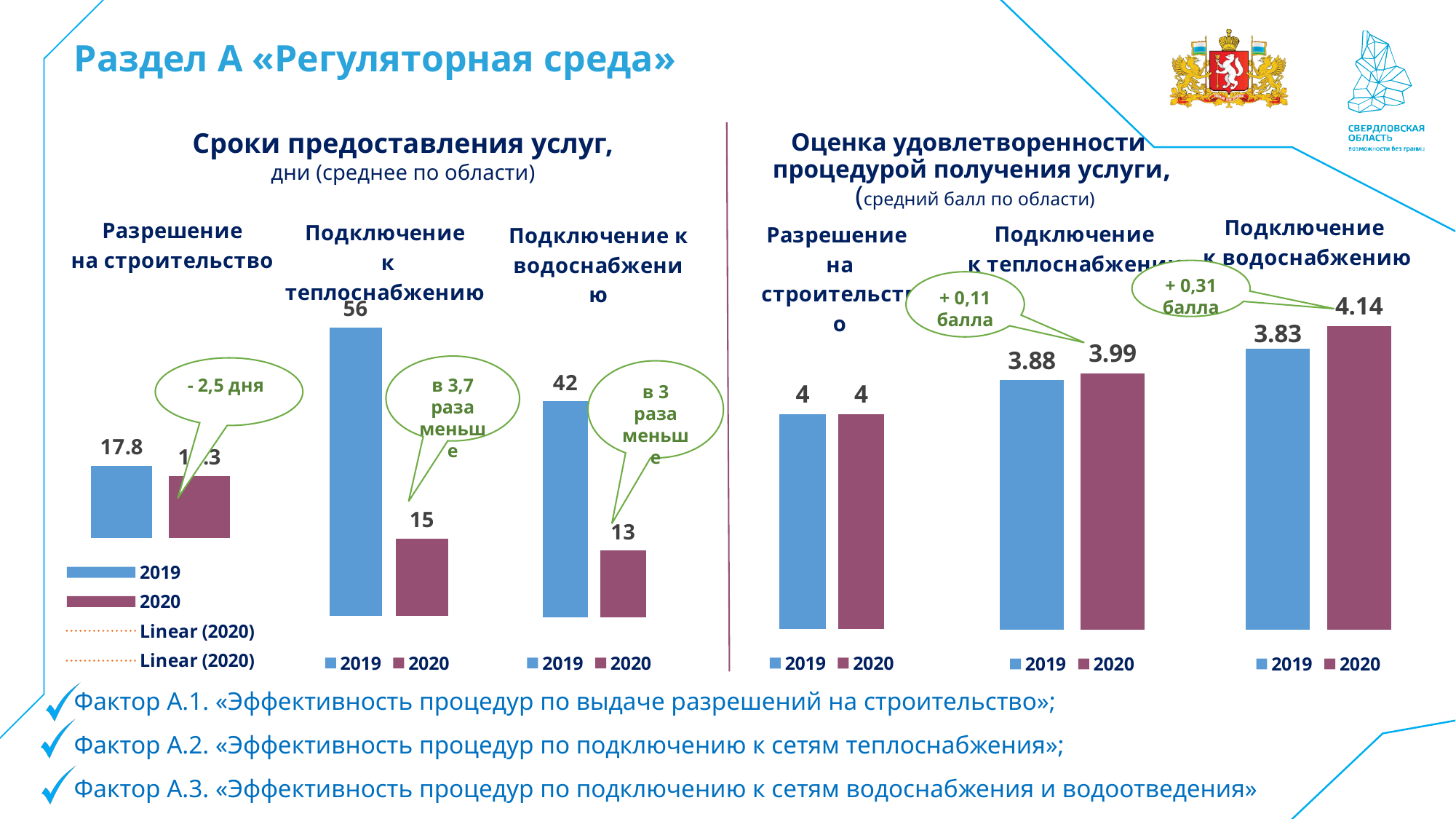
In the 'Оценка удовлетворенности' chart for 'Подключение к водоснабжению', what is the value for 2020? 4.14 How many series does the legend list in the 'Оценка удовлетворенности' chart for 'Подключение к теплоснабжению'? 2 In the 'Сроки предоставления услуг' chart for 'Подключение к водоснабжению', what is the difference between the 2019 and 2020 values? 29 In the 'Сроки предоставления услуг' chart for 'Подключение к водоснабжению', what is the value for 2020? 13 In the 'Оценка удовлетворенности' chart for 'Разрешение на строительство', what is the value for 2020? 4 In the 'Сроки предоставления услуг' chart for 'Подключение к теплоснабжению', what is the value for 2020? 15 In the 'Сроки предоставления услуг' chart for 'Подключение к теплоснабжению', what is the value for 2019? 56 In the 'Сроки предоставления услуг' chart for 'Разрешение на строительство', what is the value for 2019? 17.8 What type of chart is used for 'Сроки предоставления услуг' on the slide? Bar chart In the 'Сроки предоставления услуг' chart for 'Подключение к теплоснабжению', which year has the larger value, 2019 or 2020? 2019 In the 'Оценка удовлетворенности' chart for 'Подключение к теплоснабжению', what is the value for 2019? 3.88 In the 'Оценка удовлетворенности' chart for 'Подключение к водоснабжению', what is the difference between the 2020 and 2019 values? 0.31